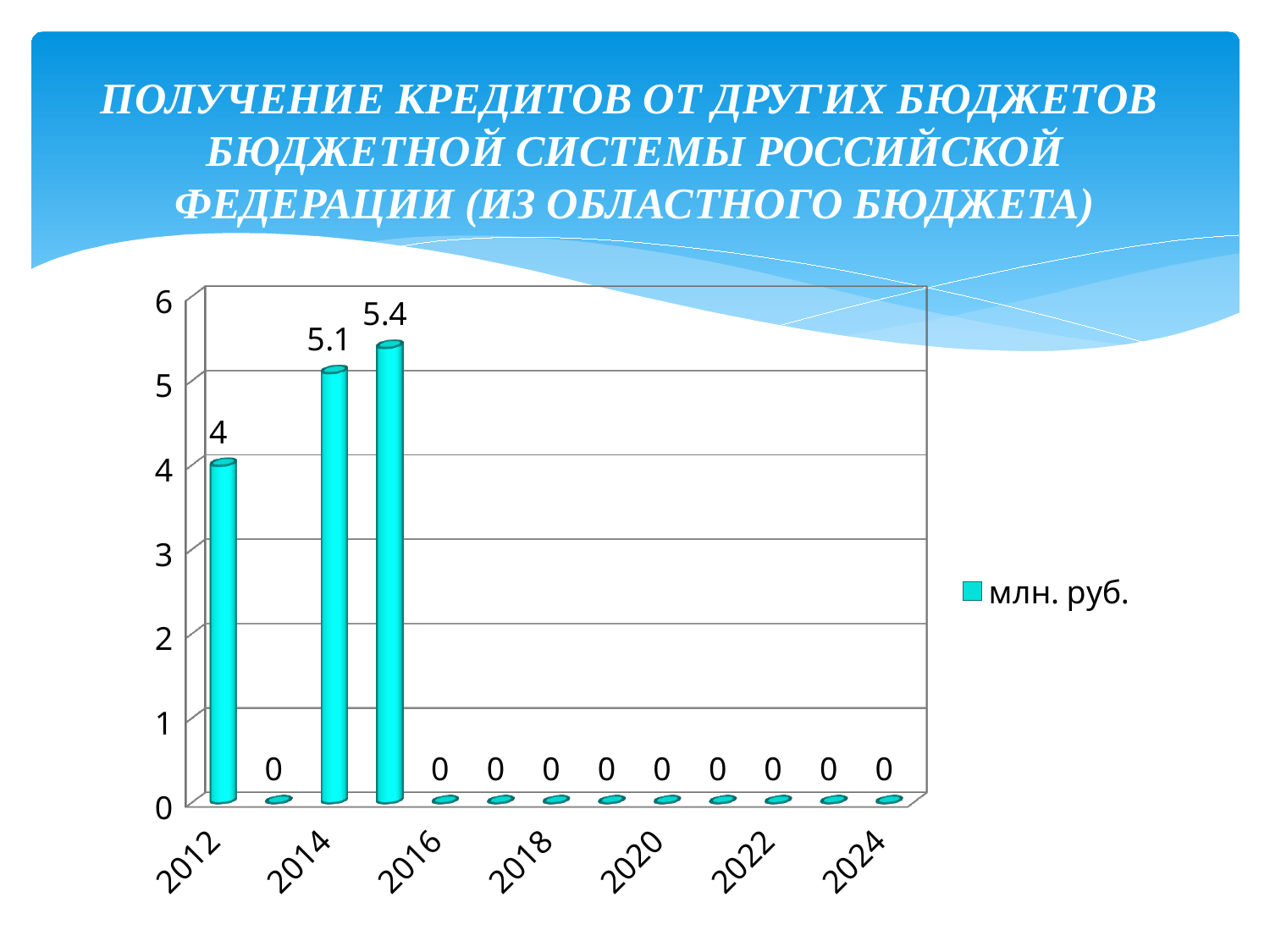
What kind of chart is shown on the slide? bar chart Which is larger, the value for 2012 or the value for 2014? 2014 What is the difference between the values for 2014 and 2012? 1.1 What is the value for 2012? 4 What is the legend entry for the series? млн. руб. Is the value for 2014 greater or less than 5? greater How many series does the legend list? 1 What is the value for 2024? 0 What is the value for 2014? 5.1 What is the highest value shown on the chart? 5.4 What is the value for 2016? 0 How many bars are plotted on the chart? 13